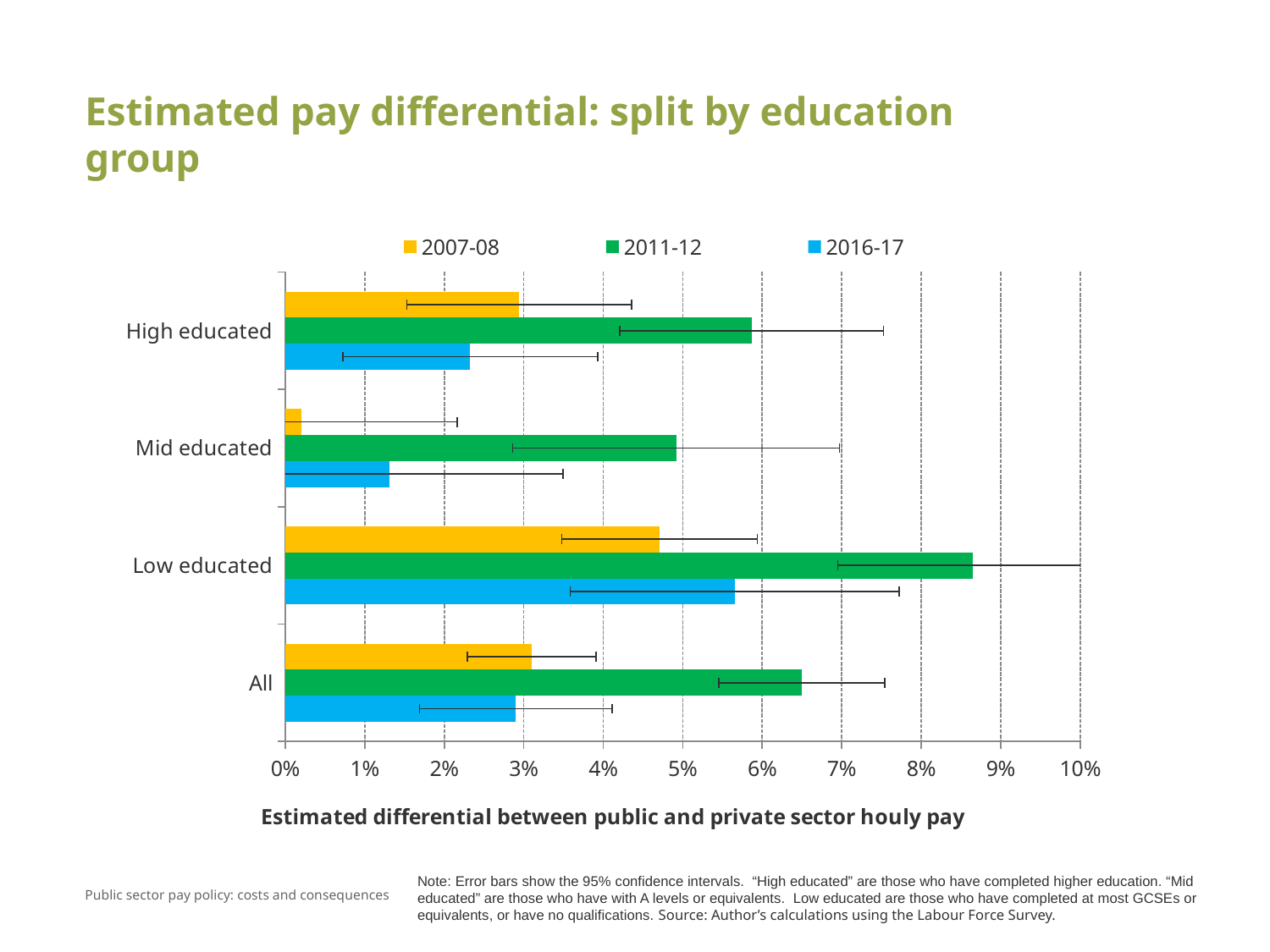
What is the label shown below the horizontal axis of the chart? Estimated differential between public and private sector houly pay How many education groups (categories) are shown on the chart? 4 How many series does the legend list? 3 Which education group has the highest value for 2011-12? Low educated For High educated, which is larger: the 2011-12 value or the 2016-17 value? 2011-12 Is the value for All in 2011-12 greater or less than 6%? greater Which education group has the highest value for 2016-17? Low educated What kind of chart is shown on the slide? Bar chart Is the value for Low educated in 2011-12 greater or less than 8%? greater For Mid educated, which is larger: the 2007-08 value or the 2016-17 value? 2016-17 Which education group has the lowest value for 2007-08? Mid educated Is the value for Mid educated in 2007-08 greater or less than 1%? less